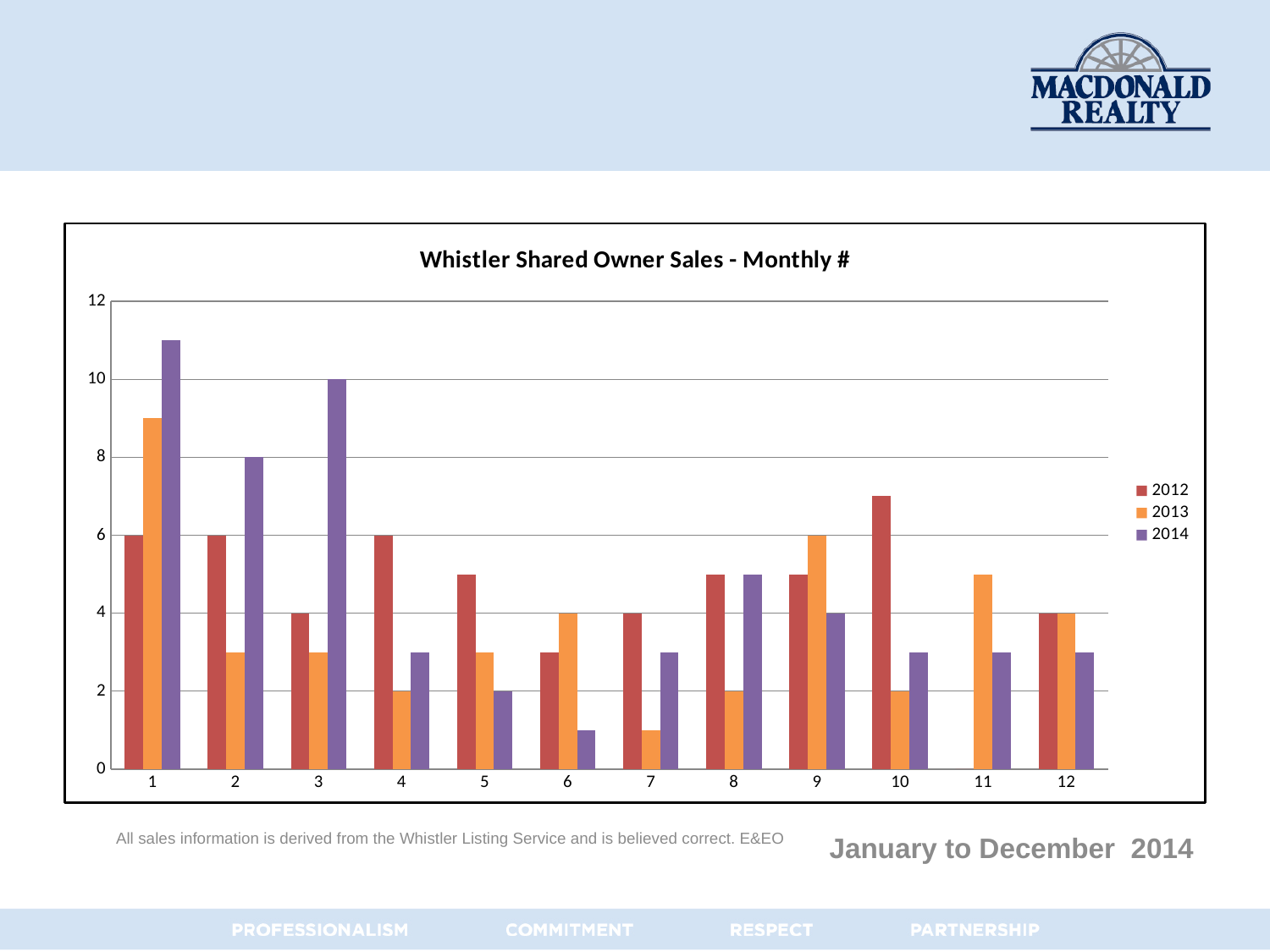
Which month has the highest value for the 2014 series? 1 Which month has the highest value for the 2012 series? 10 What is the title of the chart? Whistler Shared Owner Sales - Monthly # In month 5, which series has the larger value, 2012 or 2014? 2012 How many series does the legend list? 3 What is the value for 2012 in month 1? 6 How many months (categories) are shown on the x axis? 12 What is the value for 2014 in month 3? 10 Is the value for 2014 in month 1 greater or less than 10? greater What is the value for 2013 in month 9? 6 What is the difference between the 2014 values for month 3 and month 2? 2 What kind of chart is shown on the slide? bar chart